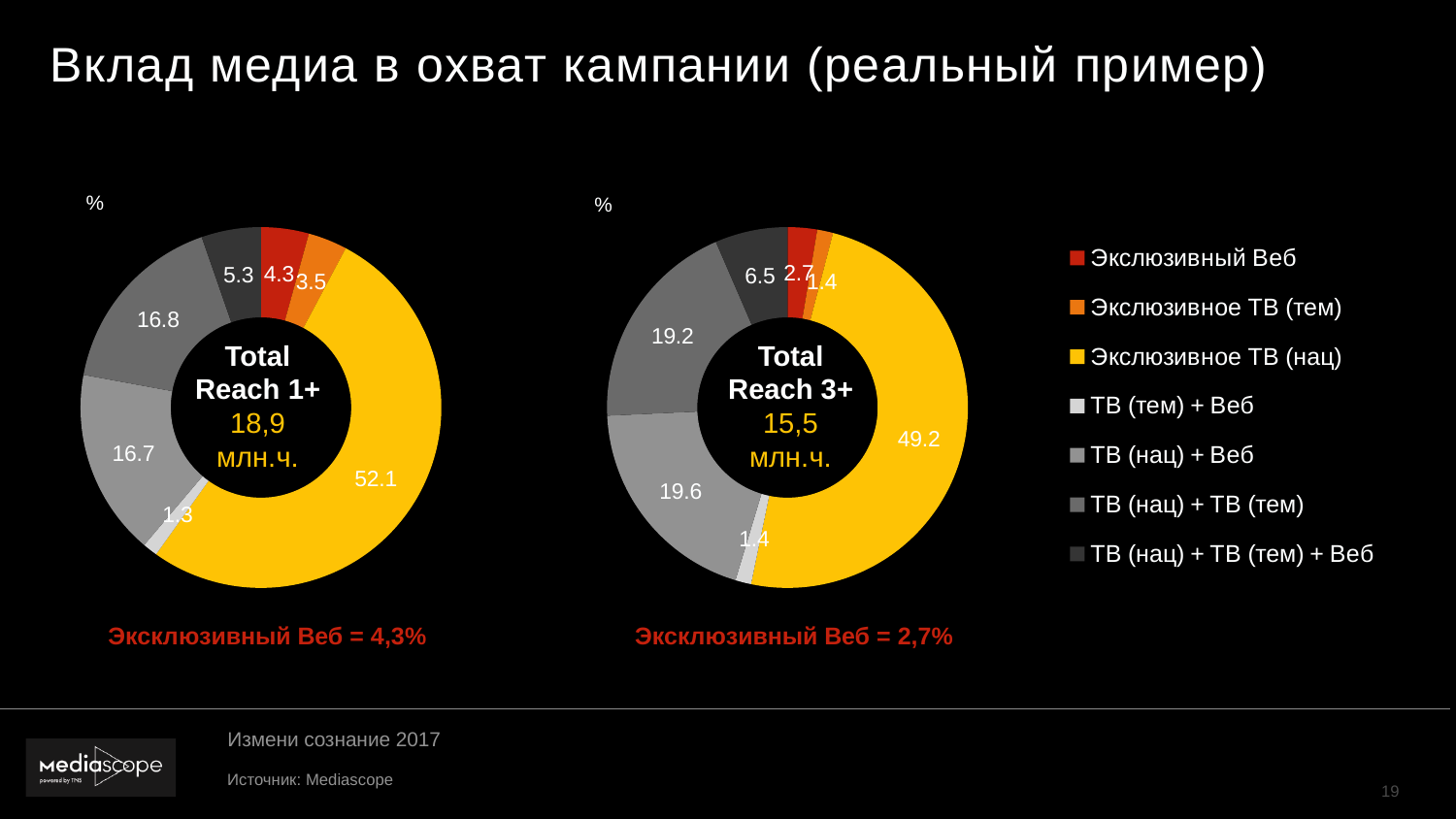
In the right chart (Total Reach 3+), which category has the largest slice? Эксклюзивное ТВ (нац) How many categories does the legend list? 7 In the left chart (Total Reach 1+), what is the value for Эксклюзивное ТВ (нац)? 52.1 In the right chart (Total Reach 3+), what is the value for Эксклюзивный Веб? 2.7 In the right chart (Total Reach 3+), what is the value for Эксклюзивное ТВ (нац)? 49.2 What is the difference between the Эксклюзивный Веб value in the left chart (Total Reach 1+) and in the right chart (Total Reach 3+)? 1.6 How many slices does the left chart (Total Reach 1+) have? 7 What kind of chart is used on this slide? Pie (donut) chart Is the value for Эксклюзивное ТВ (тем) larger in the left chart (Total Reach 1+) or in the right chart (Total Reach 3+)? Left chart (Total Reach 1+) In the left chart (Total Reach 1+), what is the value for Эксклюзивный Веб? 4.3 In the left chart (Total Reach 1+), which category has the largest slice? Эксклюзивное ТВ (нац) What total reach figure is shown in the centre of the left chart (Total Reach 1+)? 18,9 млн.ч.